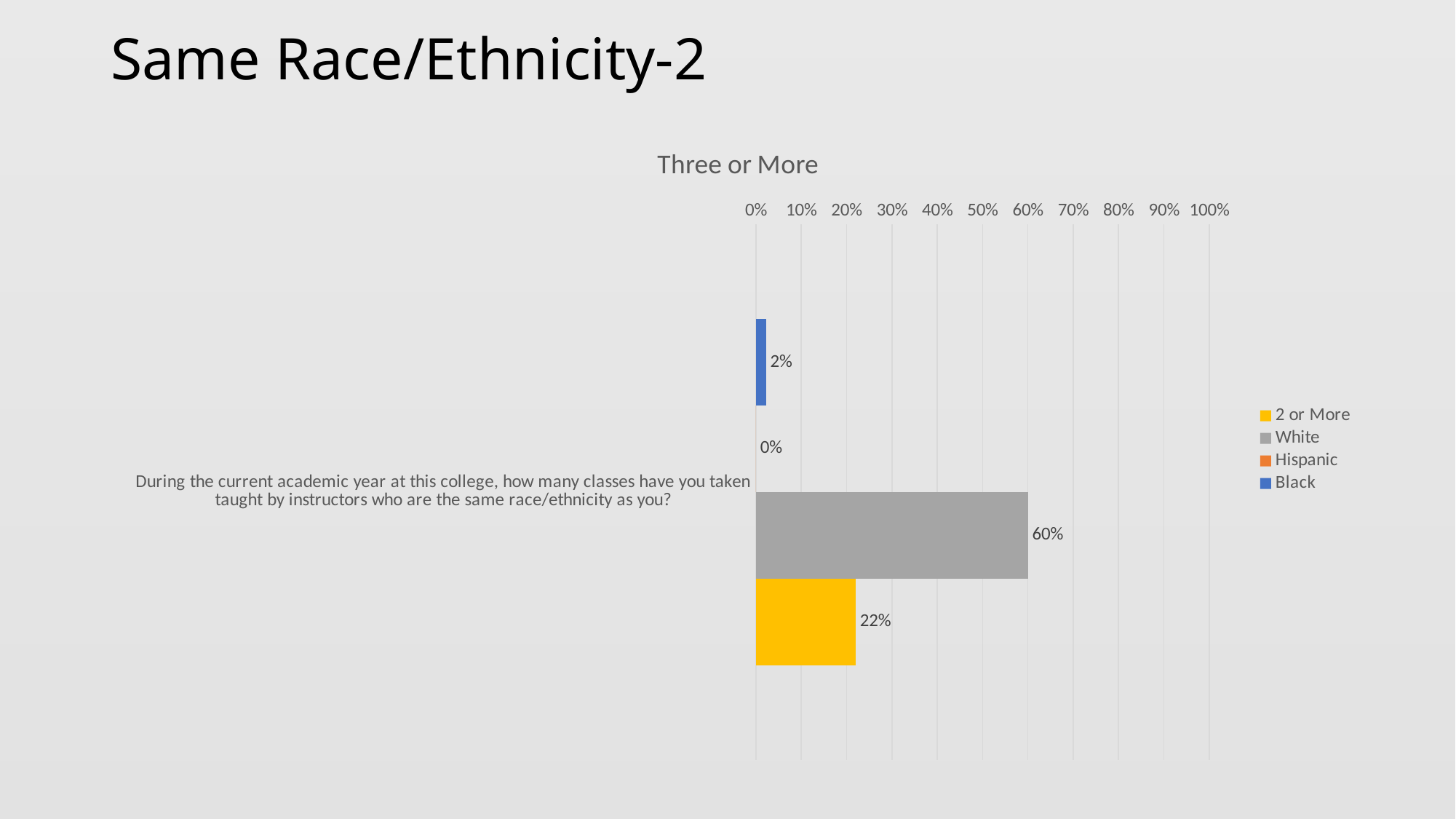
How many series does the legend list? 4 What is the difference between the values for White and 2 or More? 38% What is the value for Black? 2% Which is larger, the value for 2 or More or the value for Black? 2 or More What is the value for 2 or More? 22% Is the value for White greater or less than 50%? greater What kind of chart is shown? Bar chart Which series has the highest value? White What is the title of the chart? Three or More What is the value for Hispanic? 0% What is the value for White? 60% Which series has the lowest value? Hispanic